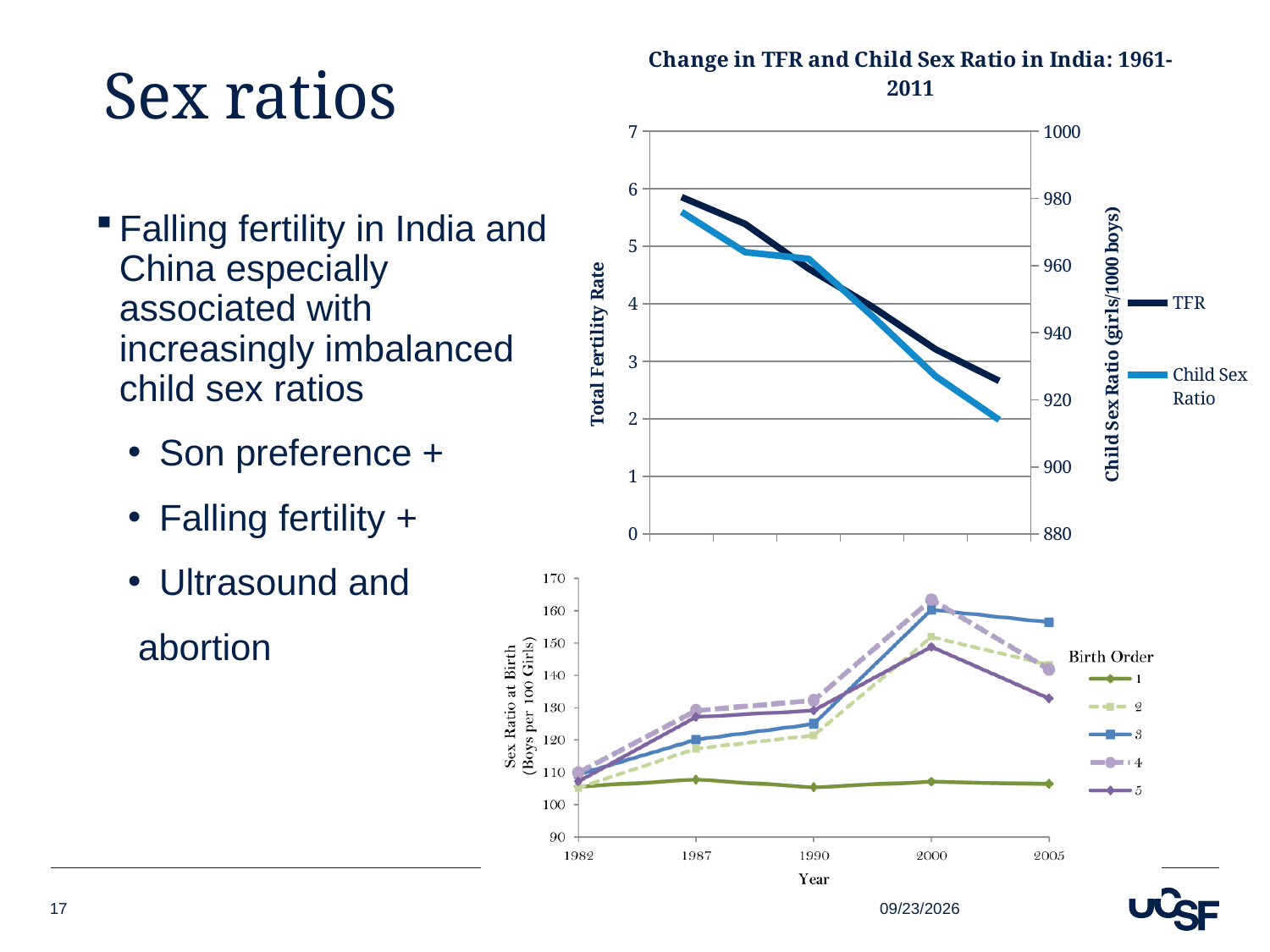
In the bottom chart showing Sex Ratio at Birth by Year, how many years are labelled on the x axis? 5 In the bottom chart showing Sex Ratio at Birth by Year, is the value for birth order 3 in 2000 greater or less than 150? greater In the bottom chart showing Sex Ratio at Birth by Year, how many series does the legend list? 5 In the top chart 'Change in TFR and Child Sex Ratio in India: 1961-2011', how many series does the legend list? 2 In the top chart 'Change in TFR and Child Sex Ratio in India: 1961-2011', is the Child Sex Ratio at the rightmost point of the line greater or less than 940? less In the bottom chart showing Sex Ratio at Birth by Year, which birth order has the lowest value in 2000? 1 In the top chart 'Change in TFR and Child Sex Ratio in India: 1961-2011', does the TFR line rise or fall along the x axis? Fall In the top chart 'Change in TFR and Child Sex Ratio in India: 1961-2011', what is the title of the right-hand vertical axis? Child Sex Ratio (girls/1000 boys) In the top chart 'Change in TFR and Child Sex Ratio in India: 1961-2011', is the TFR value at the leftmost point of the line greater or less than 5? greater What kind of chart is the top chart titled 'Change in TFR and Child Sex Ratio in India: 1961-2011'? Line chart In the bottom chart showing Sex Ratio at Birth by Year, which is larger in 1990: the value for birth order 4 or birth order 2? Birth order 4 In the bottom chart showing Sex Ratio at Birth by Year, which birth order has the highest value in 2005? 3